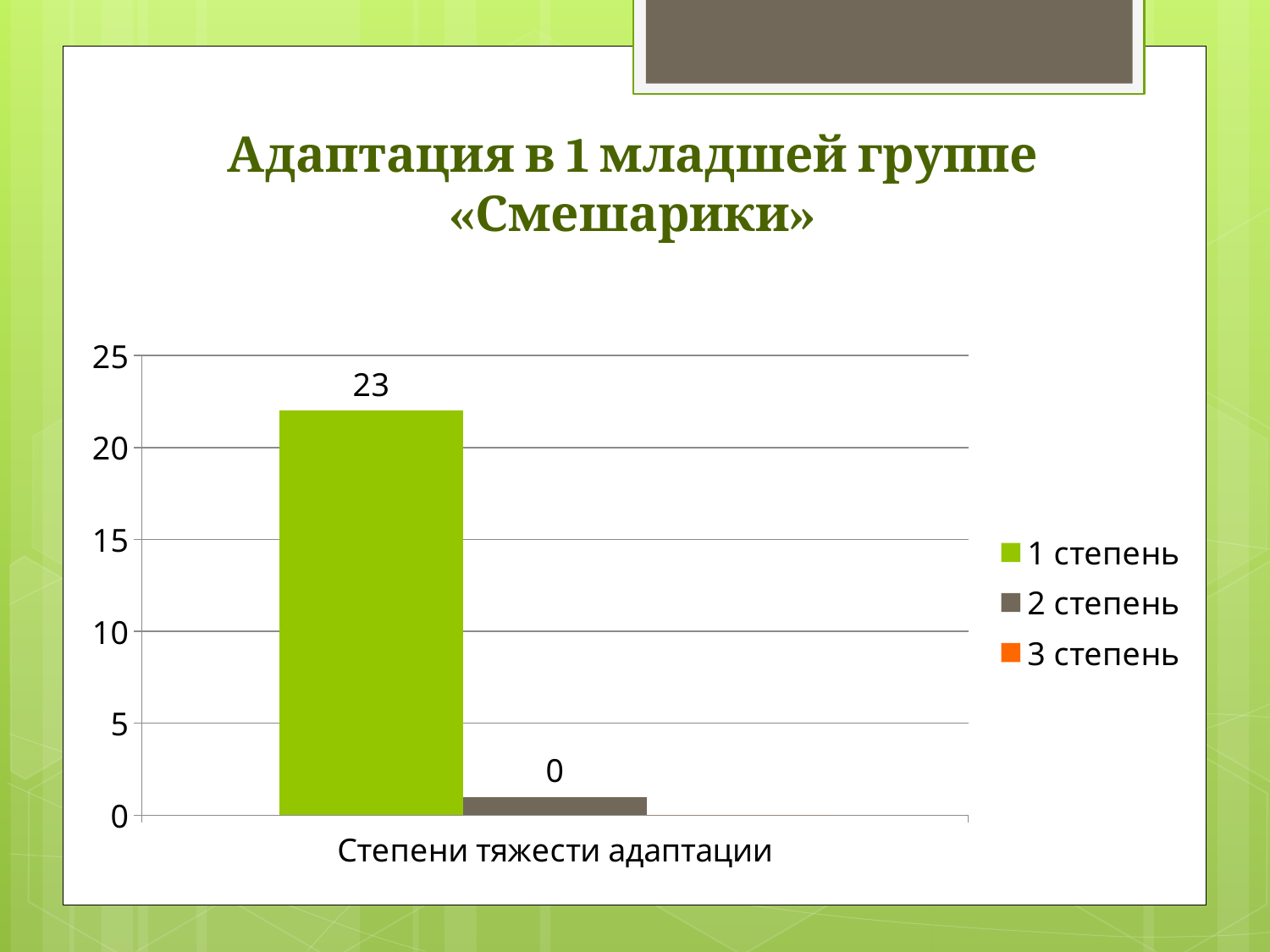
What is the value for "1 степень"? 23 What is the title of the slide? Адаптация в 1 младшей группе «Смешарики» How many series does the legend list? 3 What kind of chart is shown on the slide? bar chart Is the value for "1 степень" greater or less than 25? less How many categories are shown on the x axis? 1 Is the value for "1 степень" greater or less than 20? greater What is the category label on the x axis? Степени тяжести адаптации Which is larger, the value for "1 степень" or the value for "2 степень"? 1 степень What is the difference between the values for "1 степень" and "2 степень"? 23 What is the value labelled for "2 степень"? 0 Which series has the highest value? 1 степень